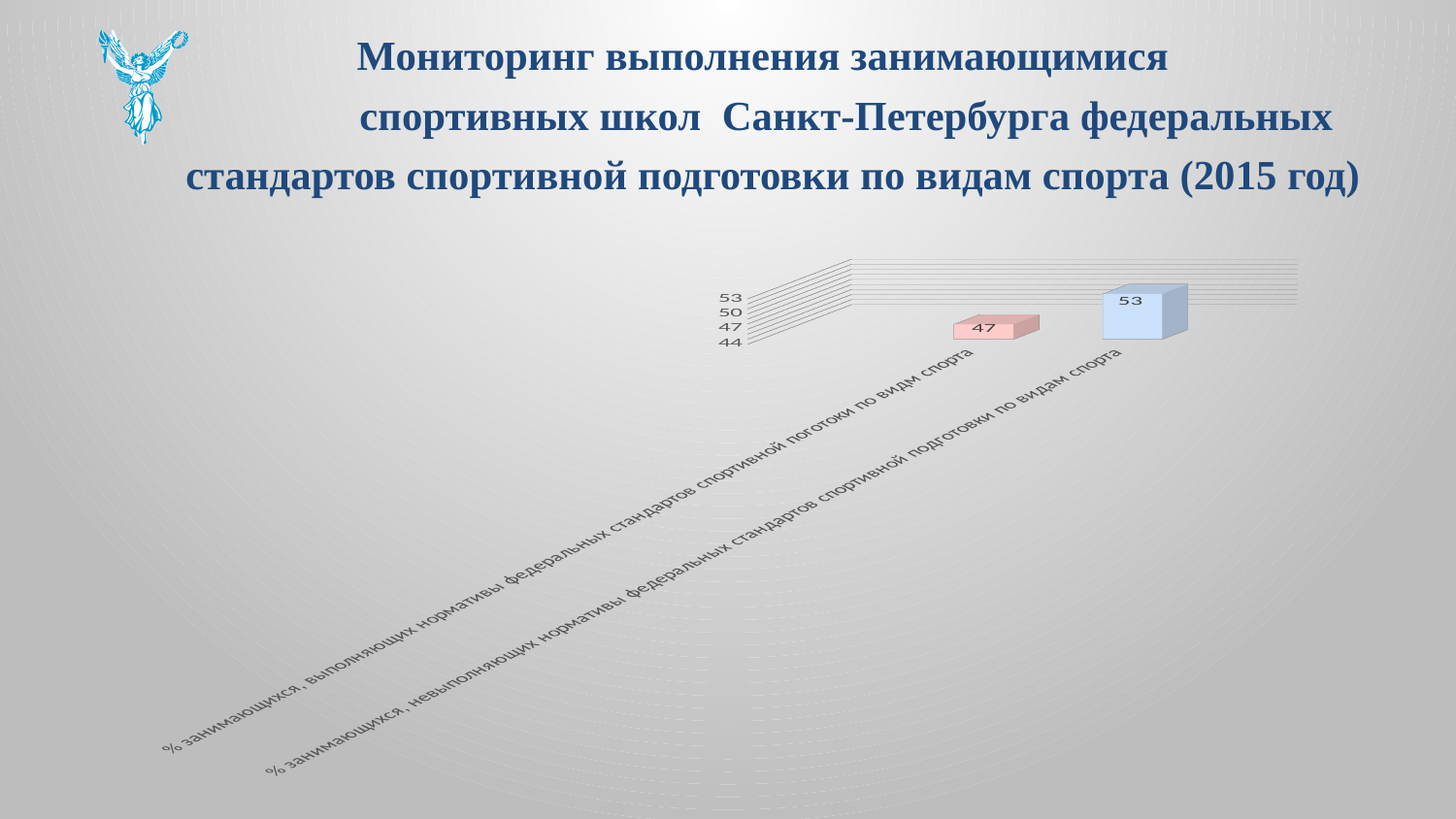
What colour is the bar for those not meeting the standards (невыполняющих)? blue What is the value for the category '% занимающихся, невыполняющих нормативы федеральных стандартов спортивной подготовки по видам спорта'? 53 What is the total of the two values shown in the chart? 100 What is the difference between the value for those not meeting the standards (невыполняющих) and those meeting the standards (выполняющих)? 6 What is the value for the category '% занимающихся, выполняющих нормативы федеральных стандартов спортивной подготовки по видам спорта'? 47 Is the value for those not meeting the standards (невыполняющих) greater or less than 50? greater Is the value for those meeting the standards (выполняющих) greater or less than 50? less Which category has the lowest value? % занимающихся, выполняющих нормативы федеральных стандартов спортивной подготовки по видам спорта How many categories are shown in the chart? 2 Which is larger: the value for those meeting the standards (выполняющих) or those not meeting the standards (невыполняющих)? невыполняющих Which category has the highest value? % занимающихся, невыполняющих нормативы федеральных стандартов спортивной подготовки по видам спорта What kind of chart is shown on the slide? bar chart